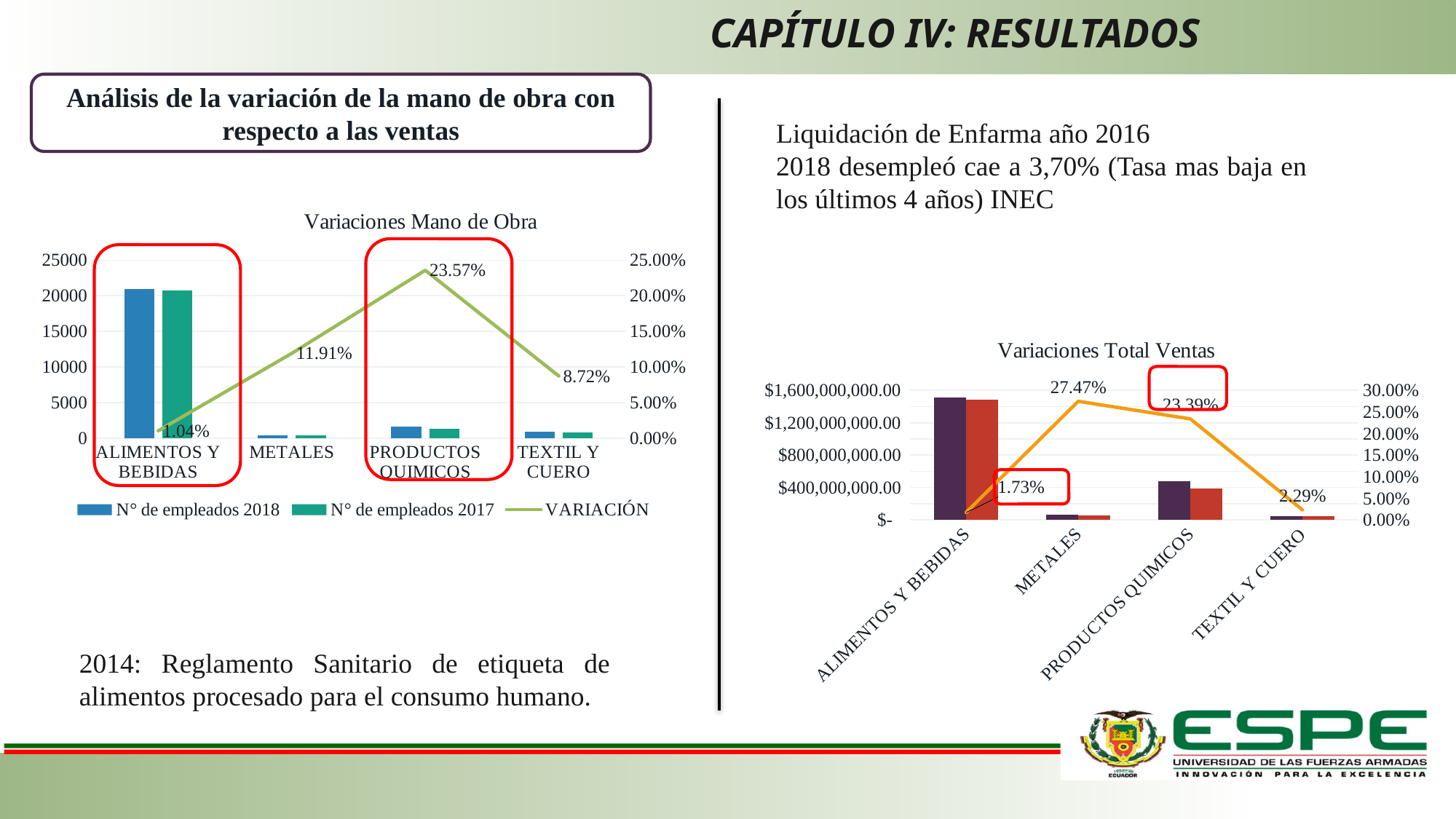
In the 'Variaciones Total Ventas' chart, what is the variation value for TEXTIL Y CUERO? 2.29% In the 'Variaciones Mano de Obra' chart, what is the VARIACIÓN value for ALIMENTOS Y BEBIDAS? 1.04% How many categories are shown on the x axis of the 'Variaciones Total Ventas' chart? 4 In the 'Variaciones Mano de Obra' chart, is the number of employees in 2018 for ALIMENTOS Y BEBIDAS greater or less than 20000? greater In the 'Variaciones Total Ventas' chart, which category has the highest variation percentage? METALES In the 'Variaciones Mano de Obra' chart, which category has the lowest VARIACIÓN? ALIMENTOS Y BEBIDAS In the 'Variaciones Mano de Obra' chart, which category has the highest VARIACIÓN? PRODUCTOS QUIMICOS How many series does the legend of the 'Variaciones Mano de Obra' chart list? 3 In the 'Variaciones Total Ventas' chart, what is the variation value for METALES? 27.47% In the 'Variaciones Total Ventas' chart, which is larger: the variation for PRODUCTOS QUIMICOS or for TEXTIL Y CUERO? PRODUCTOS QUIMICOS In the 'Variaciones Mano de Obra' chart, what is the VARIACIÓN value for PRODUCTOS QUIMICOS? 23.57% In the 'Variaciones Mano de Obra' chart, what is the difference between the VARIACIÓN for PRODUCTOS QUIMICOS and for METALES? 11.66%